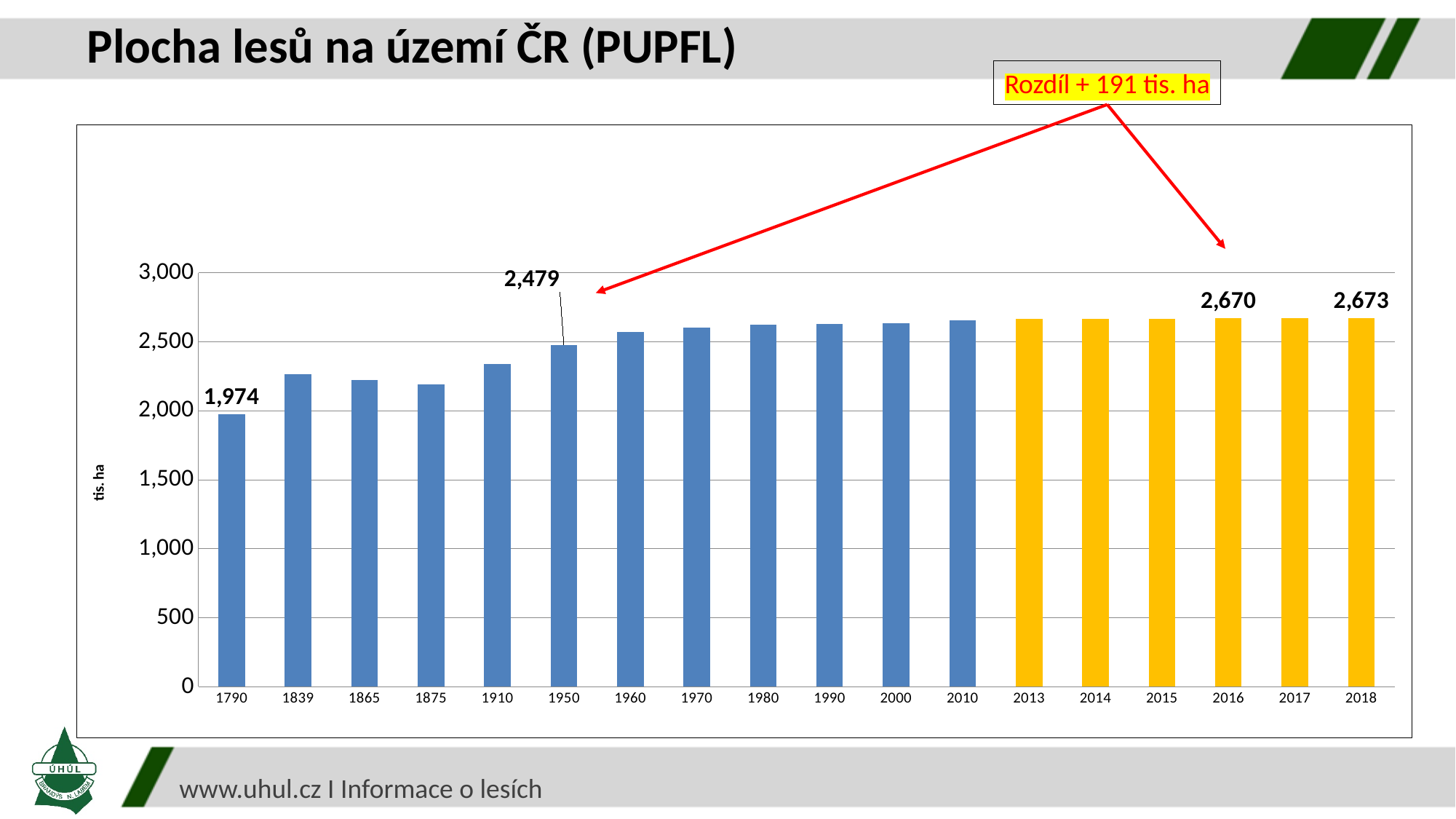
What is the value for 1790? 1,974 What is the value for 1950? 2,479 Do the values generally rise or fall from 1790 to 2018? Rise Is the value for 1910 greater or less than 2,500? less What is the value for 2018? 2,673 What is the difference between the values for 1950 and 1790? 505 How many years are shown on the x axis? 18 What is the difference between the values for 2018 and 1790? 699 Which year has the lowest value? 1790 Is the value for 1839 greater or less than 2,000? greater What type of chart is shown on the slide? Bar chart What is the value for 2016? 2,670